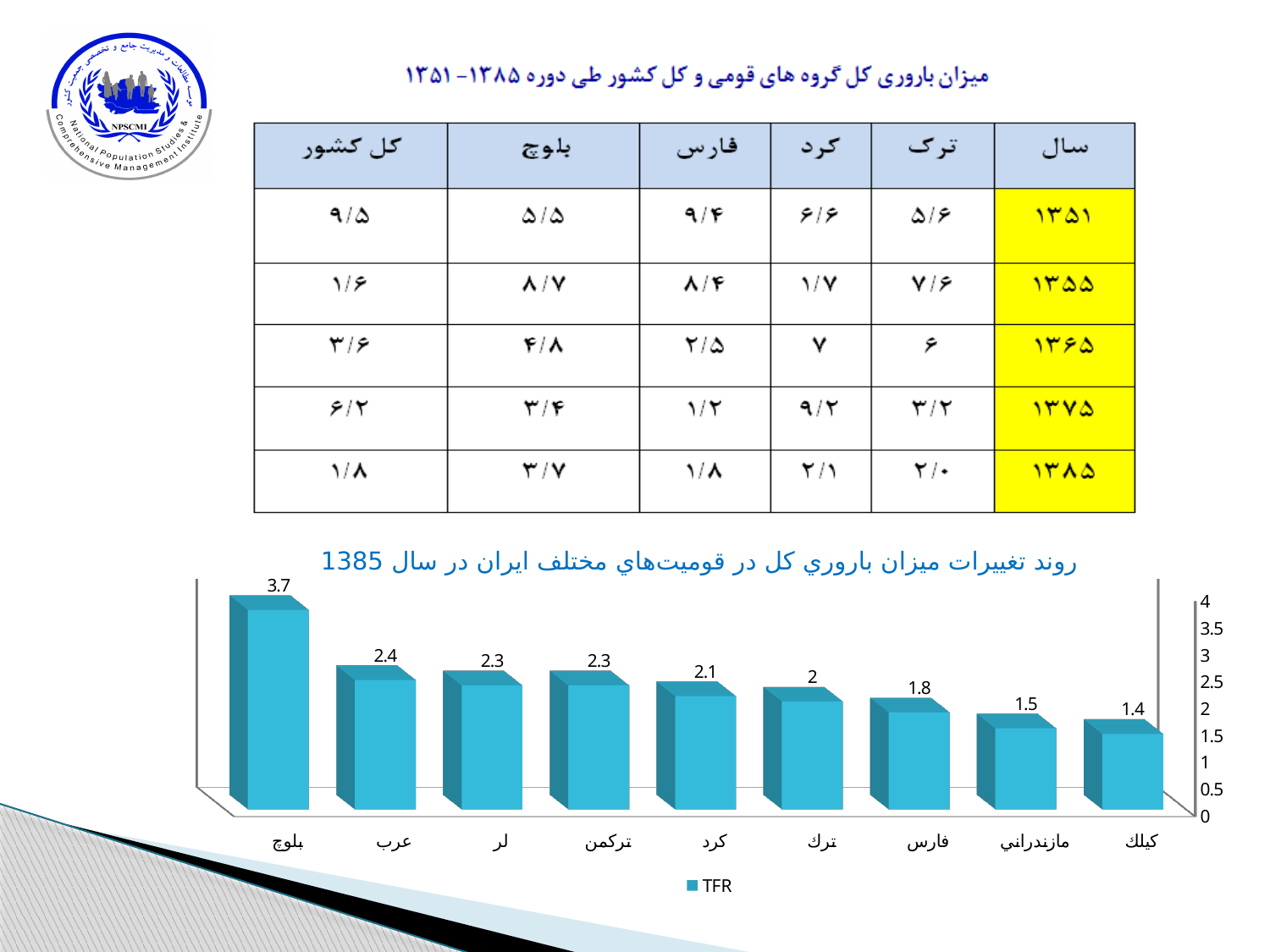
In the bar chart, which has a higher TFR, عرب or کرد? عرب What is the TFR value for بلوچ in the bar chart? 3.7 Which ethnic group has the lowest TFR in the bar chart? کیلك What kind of chart is shown at the bottom of the slide? bar chart What is the difference between the TFR of بلوچ and the TFR of کیلك in the bar chart? 2.3 What is the name of the series shown in the legend of the bar chart? TFR Is the TFR value for ترك in the bar chart greater or less than 3? less Which ethnic group has the highest TFR in the bar chart? بلوچ How many series does the legend of the bar chart list? 1 What is the TFR value for مازندراني in the bar chart? 1.5 What is the TFR value for فارس in the bar chart? 1.8 How many ethnic groups are shown in the bar chart? 9